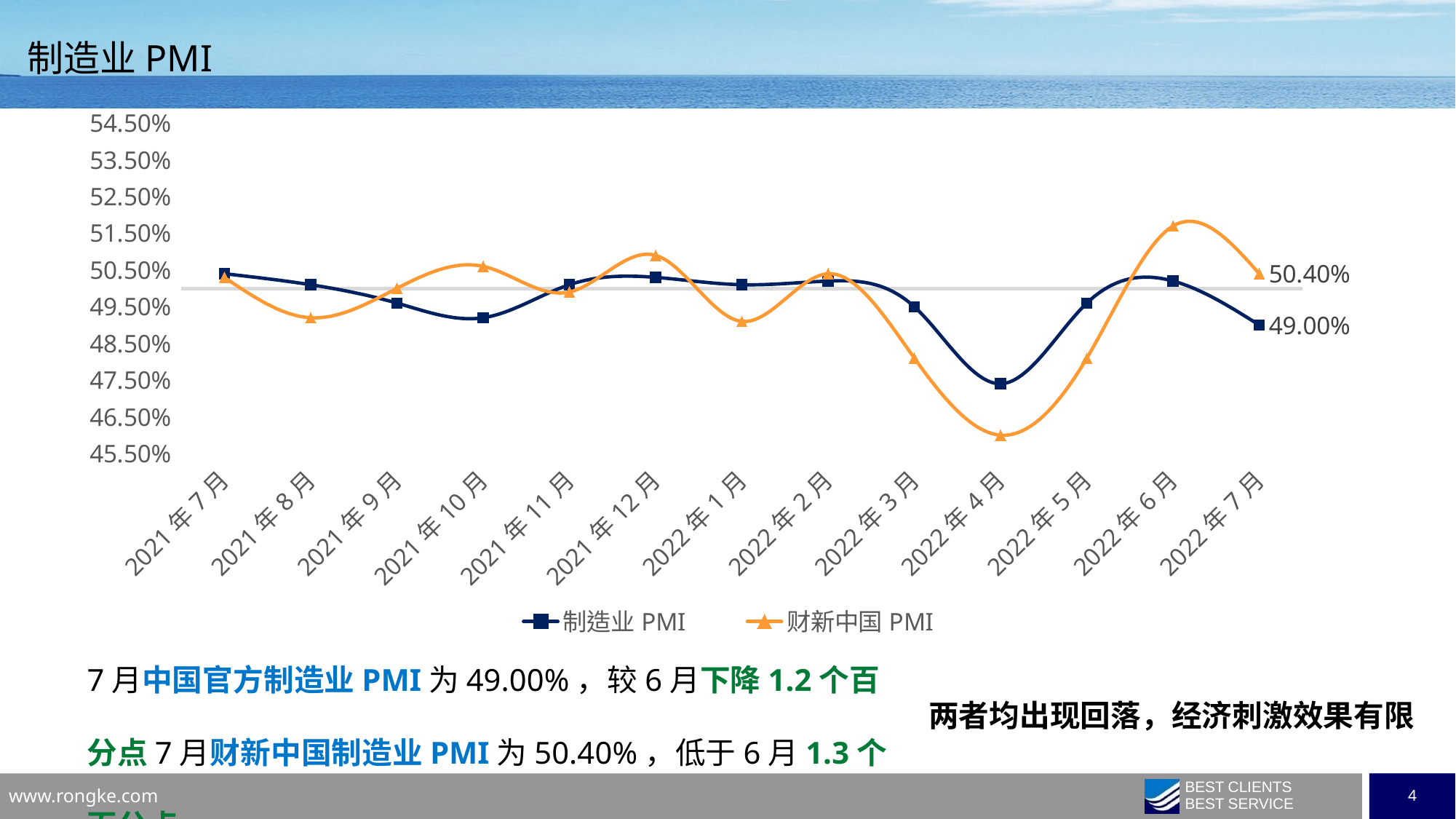
In which month is 制造业 PMI at its lowest? 2022年4月 What kind of chart is shown on the slide? Line chart What is the difference between 财新中国 PMI and 制造业 PMI at 2022年7月? 1.40% In which month is 财新中国 PMI at its lowest? 2022年4月 Does 制造业 PMI rise or fall from 2022年6月 to 2022年7月? Fall At 2022年7月, which series has the higher value, 制造业 PMI or 财新中国 PMI? 财新中国 PMI How many series does the legend list? 2 How many months are plotted along the x axis? 13 Is the value of 制造业 PMI for 2022年4月 greater or less than 48.50%? less What is the value of 制造业 PMI for 2022年7月? 49.00% In which month is 财新中国 PMI at its highest? 2022年6月 What is the value of 财新中国 PMI for 2022年7月? 50.40%